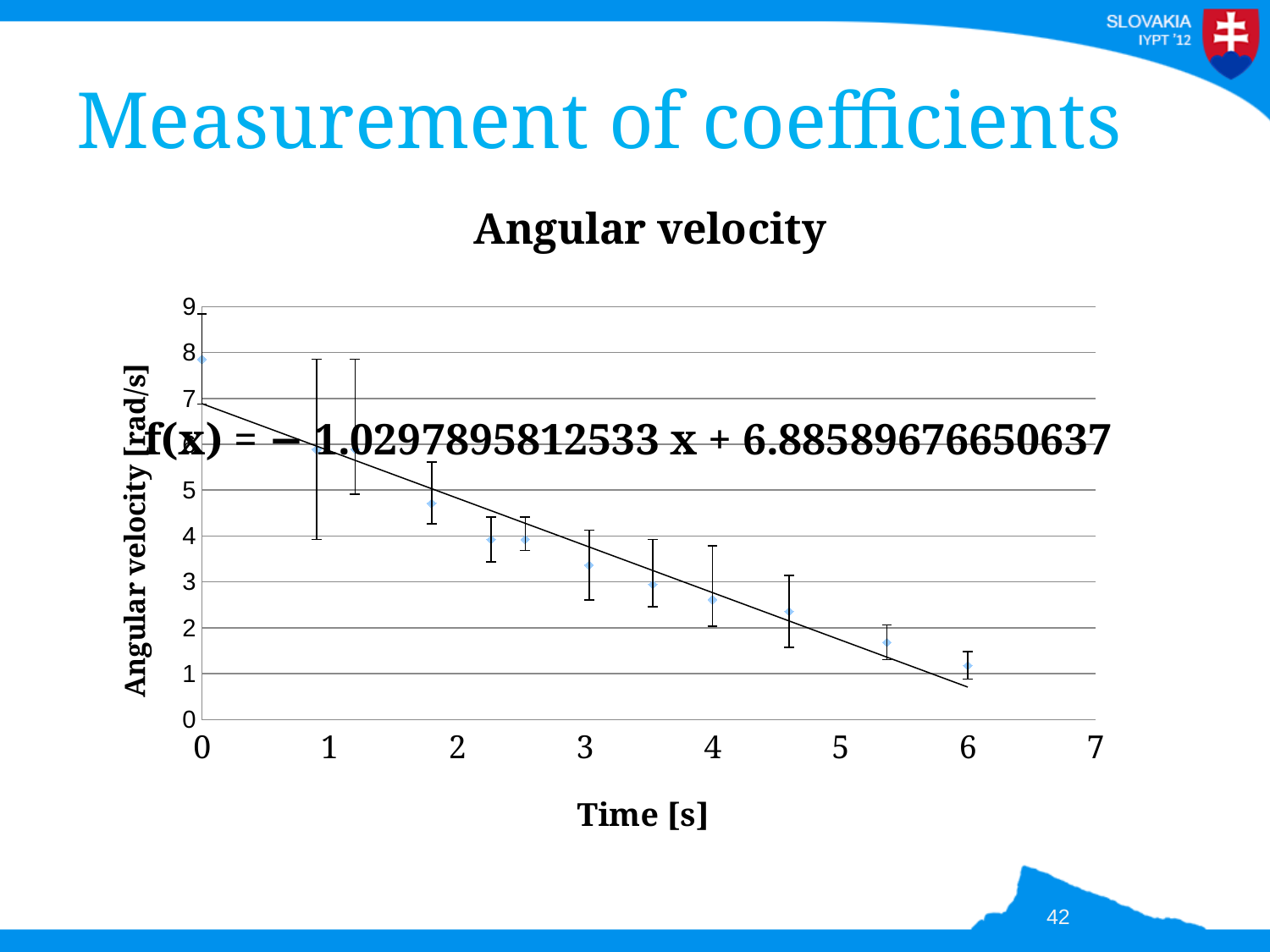
Is the angular velocity at time 0 s greater or less than 7 rad/s? greater What is the slope of the fitted line shown in the equation on the chart? −1.0297895812533 Which has the larger angular velocity: the point at 0 s or the point at 6 s? 0 s What is the title of the chart? Angular velocity How many data points are plotted on the chart? 12 What kind of chart is shown on the slide? scatter chart At which time is the angular velocity lowest? 6 s Is the angular velocity at time 4 s greater or less than 3 rad/s? less Do the angular velocity values rise or fall as time increases? fall At which time is the angular velocity highest? 0 s Is the angular velocity at time 6 s greater or less than 2 rad/s? less